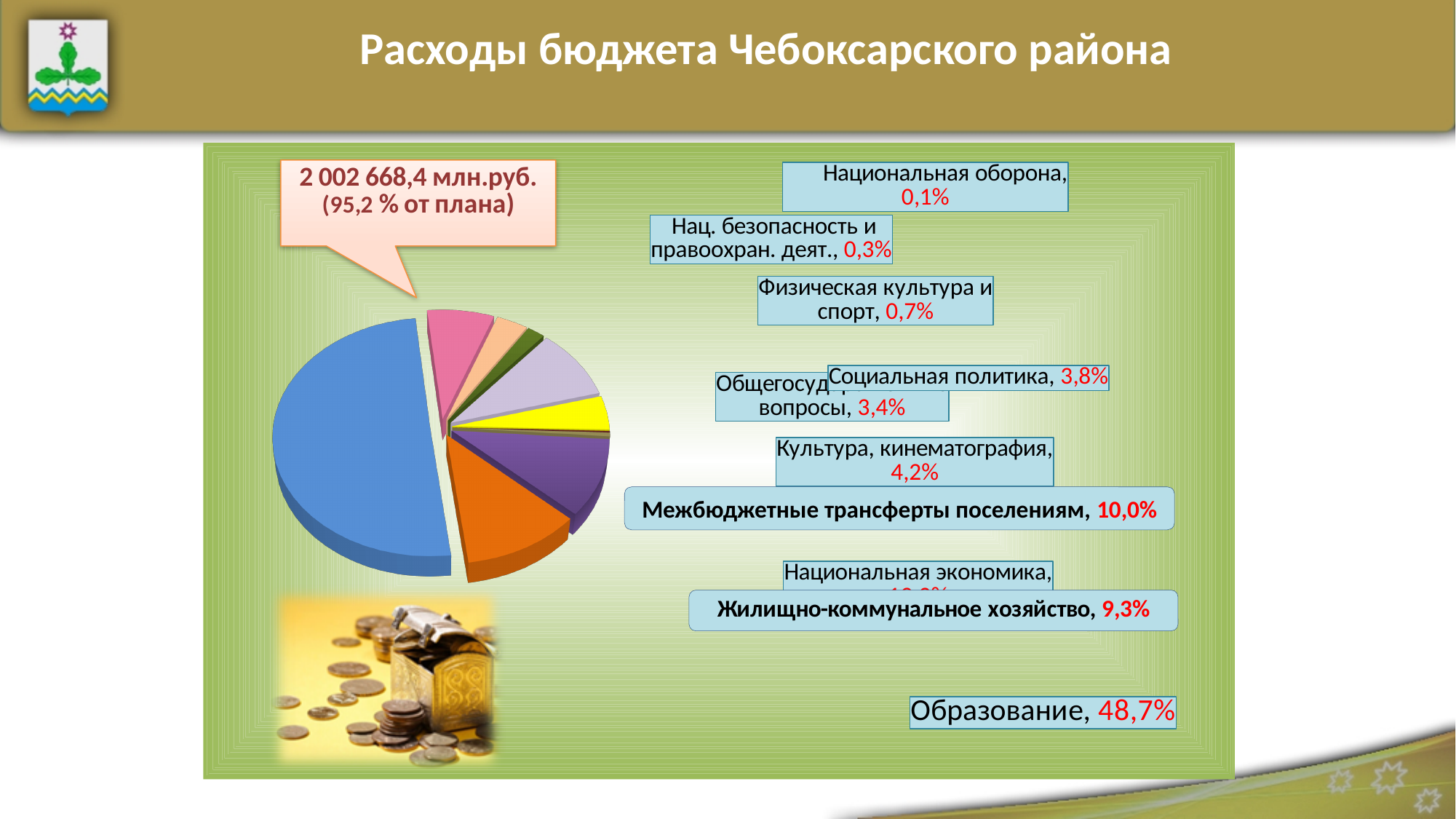
What is the value for Национальная оборона? 0,1% What is the difference between the shares of Межбюджетные трансферты поселениям and Жилищно-коммунальное хозяйство? 0,7% What share of the pie does Образование have? 48,7% What kind of chart is shown on the slide? pie chart Which is larger, the share of Социальная политика or the share of Культура, кинематография? Культура, кинематография What is the value for Жилищно-коммунальное хозяйство? 9,3% What is the value for Межбюджетные трансферты поселениям? 10,0% Which category has the smallest share of the pie? Национальная оборона What is the title of the slide? Расходы бюджета Чебоксарского района What is the value for Социальная политика? 3,8% Which category has the largest share of the pie? Образование What is the value for Культура, кинематография? 4,2%